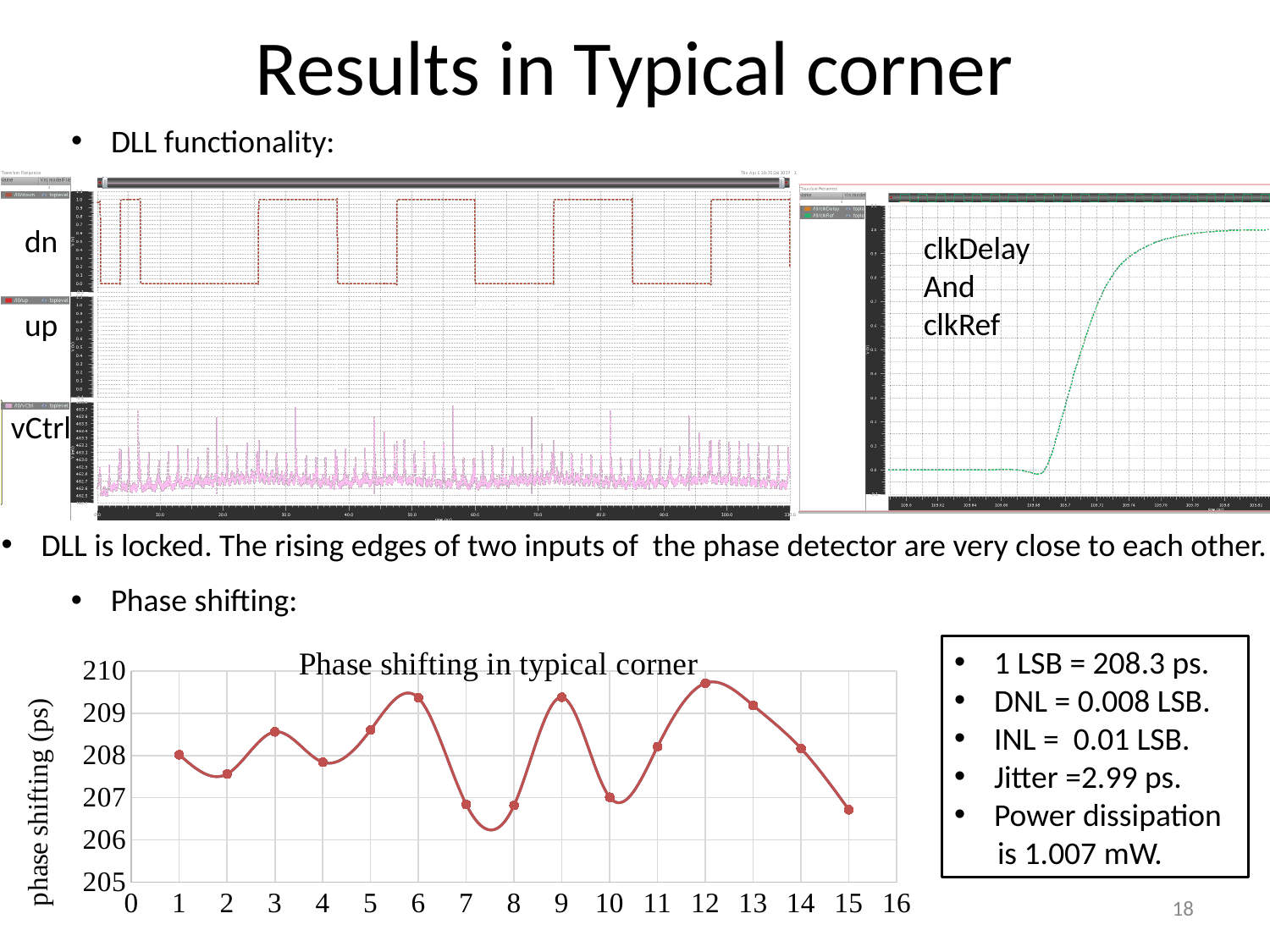
In the 'Phase shifting in typical corner' chart, is the value at x = 7 greater or less than 207? less In the 'Phase shifting in typical corner' chart, is the value at x = 12 greater or less than 209? greater In the 'Phase shifting in typical corner' chart, is the value at x = 10 greater or less than 208? less What is the title of the chart at the bottom of the slide? Phase shifting in typical corner In the 'Phase shifting in typical corner' chart, which has the larger value, x = 3 or x = 2? x = 3 How many data points are plotted in the 'Phase shifting in typical corner' chart? 15 In the 'Phase shifting in typical corner' chart, does the value rise or fall from x = 6 to x = 7? fall What is the y-axis label of the 'Phase shifting in typical corner' chart? phase shifting (ps) What kind of chart is 'Phase shifting in typical corner'? line chart In the 'Phase shifting in typical corner' chart, at which x value is the phase shifting highest? 12